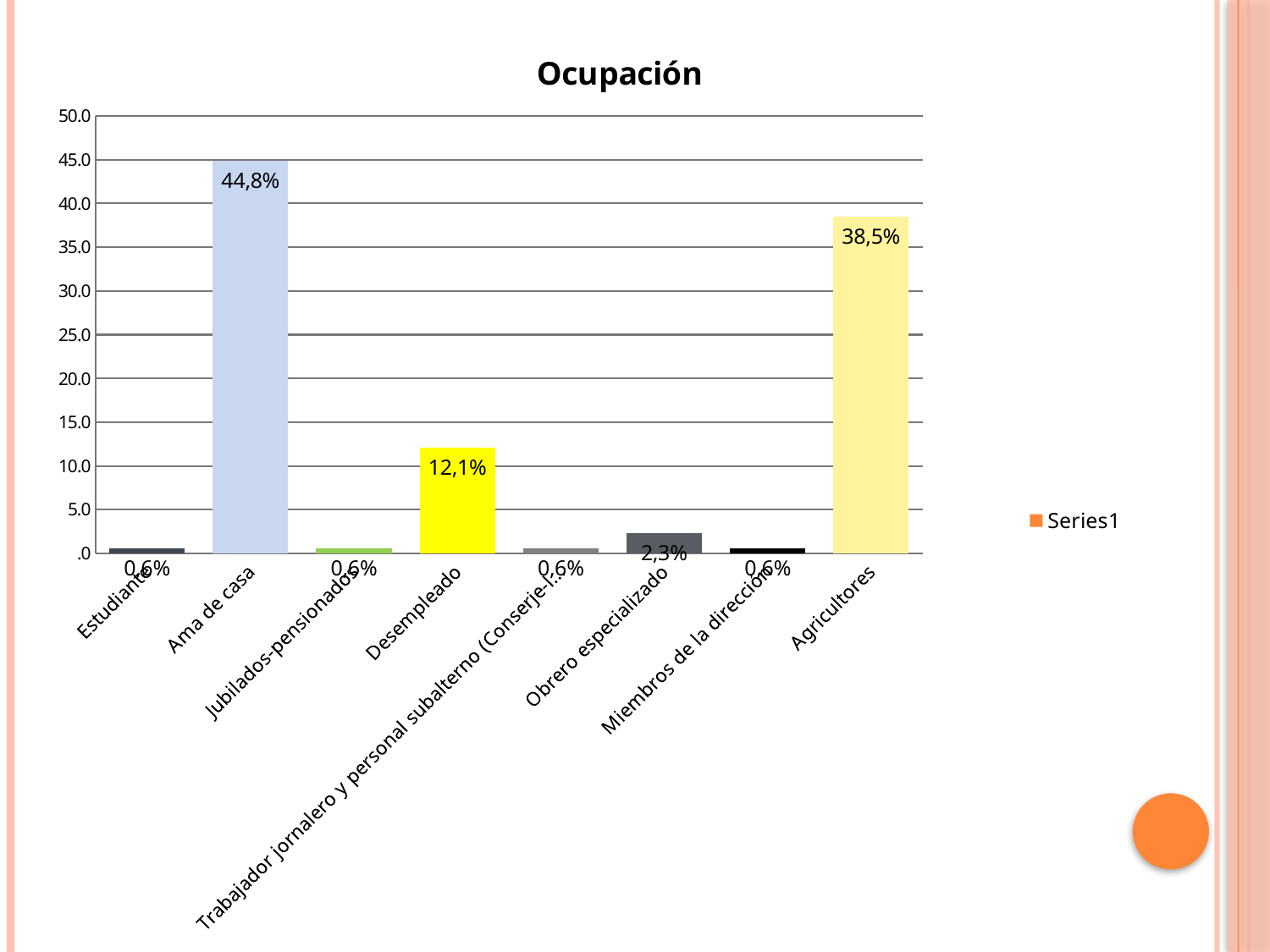
What is the difference between the values for Desempleado and Obrero especializado? 9,8% What type of chart is shown on the slide? bar chart How many series does the legend list? 1 How many categories are shown on the x axis? 8 What is the difference between the values for Ama de casa and Agricultores? 6,3% What is the value for Ama de casa? 44,8% What is the value for Obrero especializado? 2,3% What is the title of the chart? Ocupación What is the value for Agricultores? 38,5% Which is larger, the value for Desempleado or the value for Agricultores? Agricultores Which category has the highest value? Ama de casa What is the value for Desempleado? 12,1%